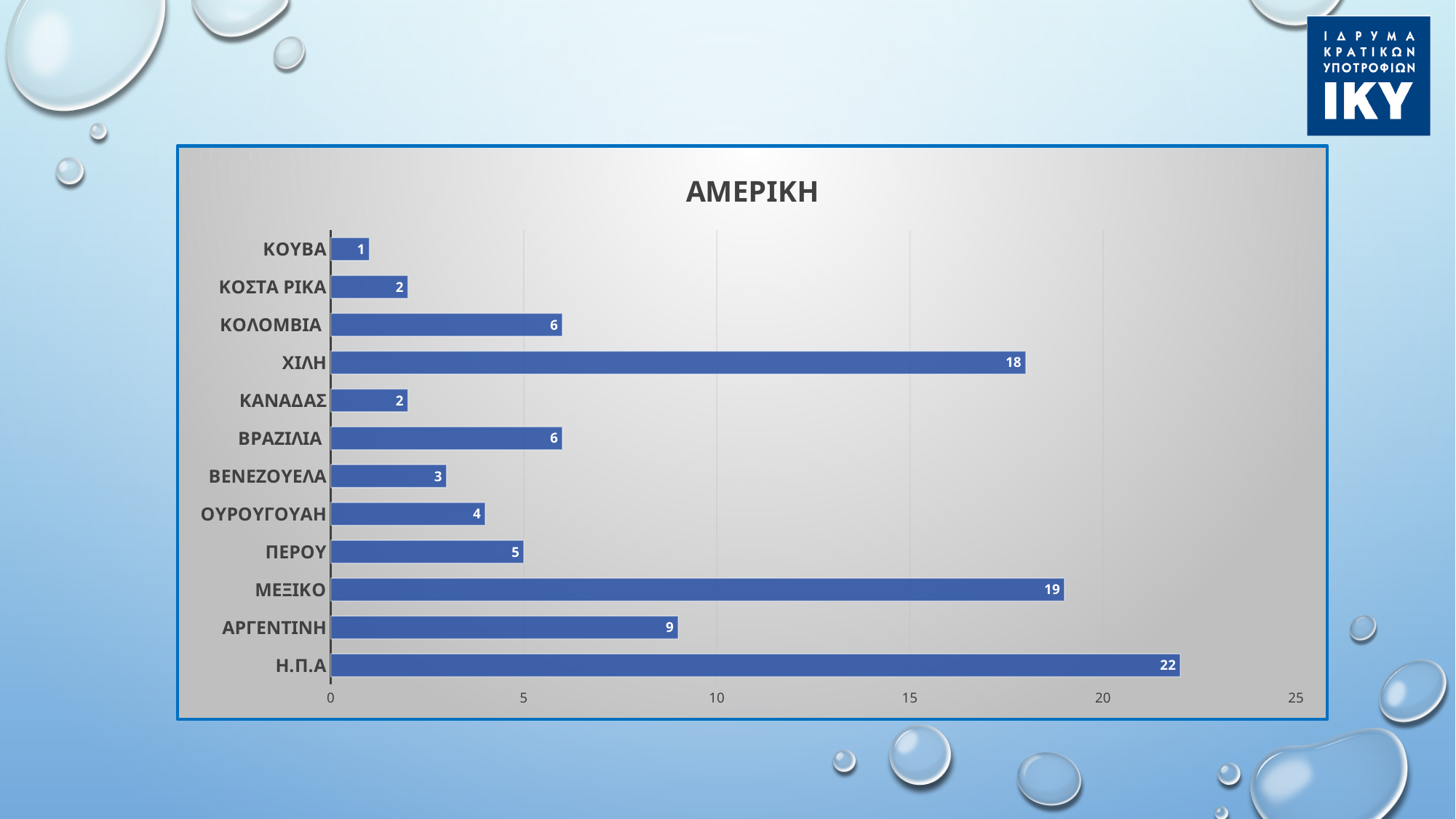
What is the value for ΑΡΓΕΝΤΙΝΗ? 9 What is the value for ΧΙΛΗ? 18 How many categories are shown in the chart? 12 What is the difference between the values for Η.Π.Α and ΜΕΞΙΚΟ? 3 Which category has the highest value? Η.Π.Α What is the title of the chart? ΑΜΕΡΙΚΗ What is the difference between the values for ΜΕΞΙΚΟ and ΑΡΓΕΝΤΙΝΗ? 10 Which category has the lowest value? ΚΟΥΒΑ Is the value for ΧΙΛΗ greater or less than 15? greater What kind of chart is shown on the slide? bar chart Which is larger, the value for ΠΕΡΟΥ or the value for ΟΥΡΟΥΓΟΥΑΗ? ΠΕΡΟΥ What is the value for Η.Π.Α? 22